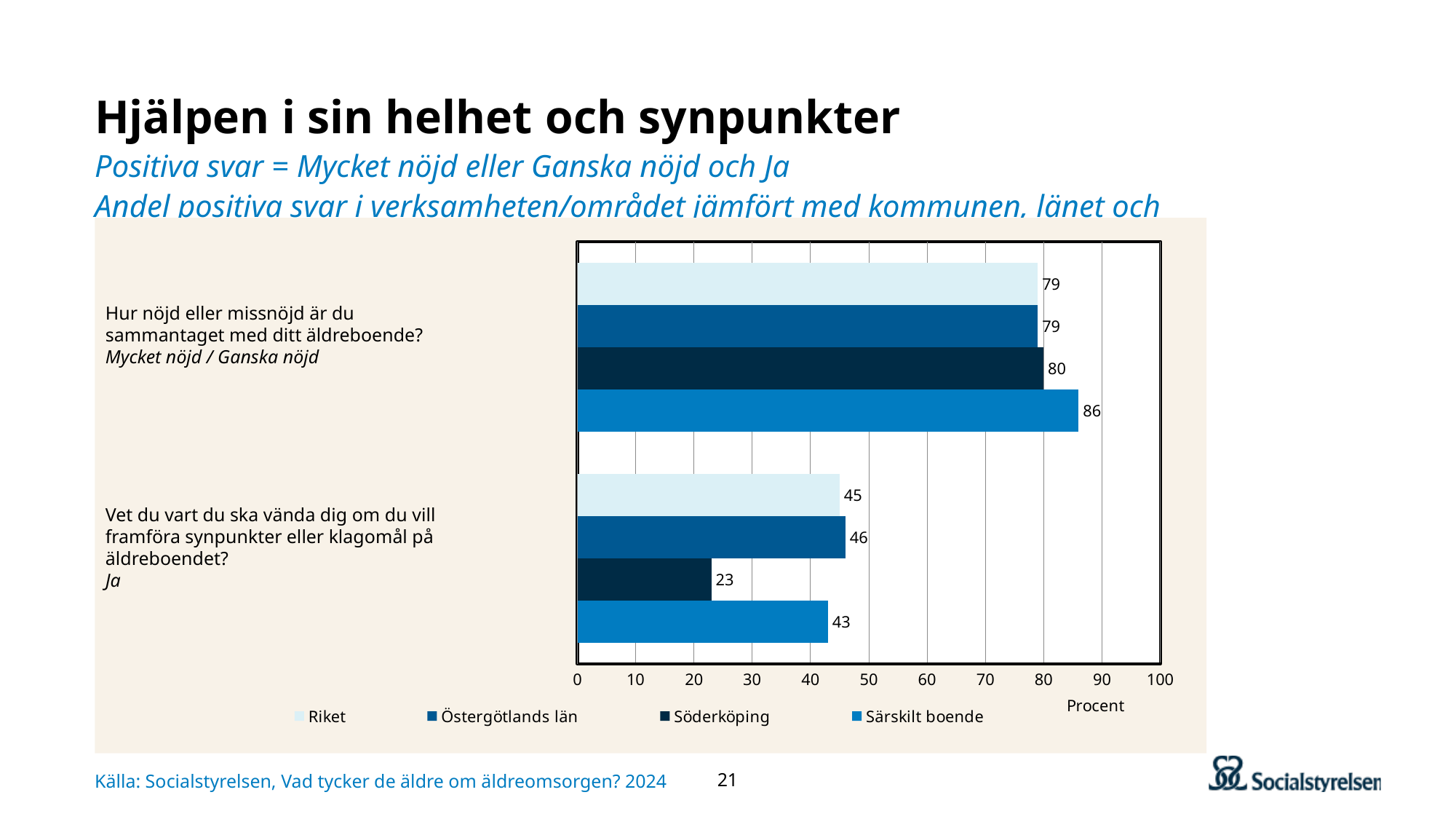
What is the value for Särskilt boende on the question "Hur nöjd eller missnöjd är du sammantaget med ditt äldreboende?"? 86 Which is larger on the question "Vet du vart du ska vända dig om du vill framföra synpunkter eller klagomål på äldreboendet?": Riket or Söderköping? Riket How many question categories are shown on the chart? 2 Which series has the lowest value on the question "Vet du vart du ska vända dig om du vill framföra synpunkter eller klagomål på äldreboendet?"? Söderköping Which series has the highest value on the question "Hur nöjd eller missnöjd är du sammantaget med ditt äldreboende?"? Särskilt boende What is the value for Söderköping on the question "Vet du vart du ska vända dig om du vill framföra synpunkter eller klagomål på äldreboendet?"? 23 What is the value for Riket on the question "Vet du vart du ska vända dig om du vill framföra synpunkter eller klagomål på äldreboendet?"? 45 How many series does the legend list? 4 What kind of chart is shown on the slide? Bar chart What is the label of the horizontal axis? Procent What is the difference between Östergötlands län and Söderköping on the question "Vet du vart du ska vända dig om du vill framföra synpunkter eller klagomål på äldreboendet?"? 23 What is the difference between Särskilt boende and Söderköping on the question "Hur nöjd eller missnöjd är du sammantaget med ditt äldreboende?"? 6